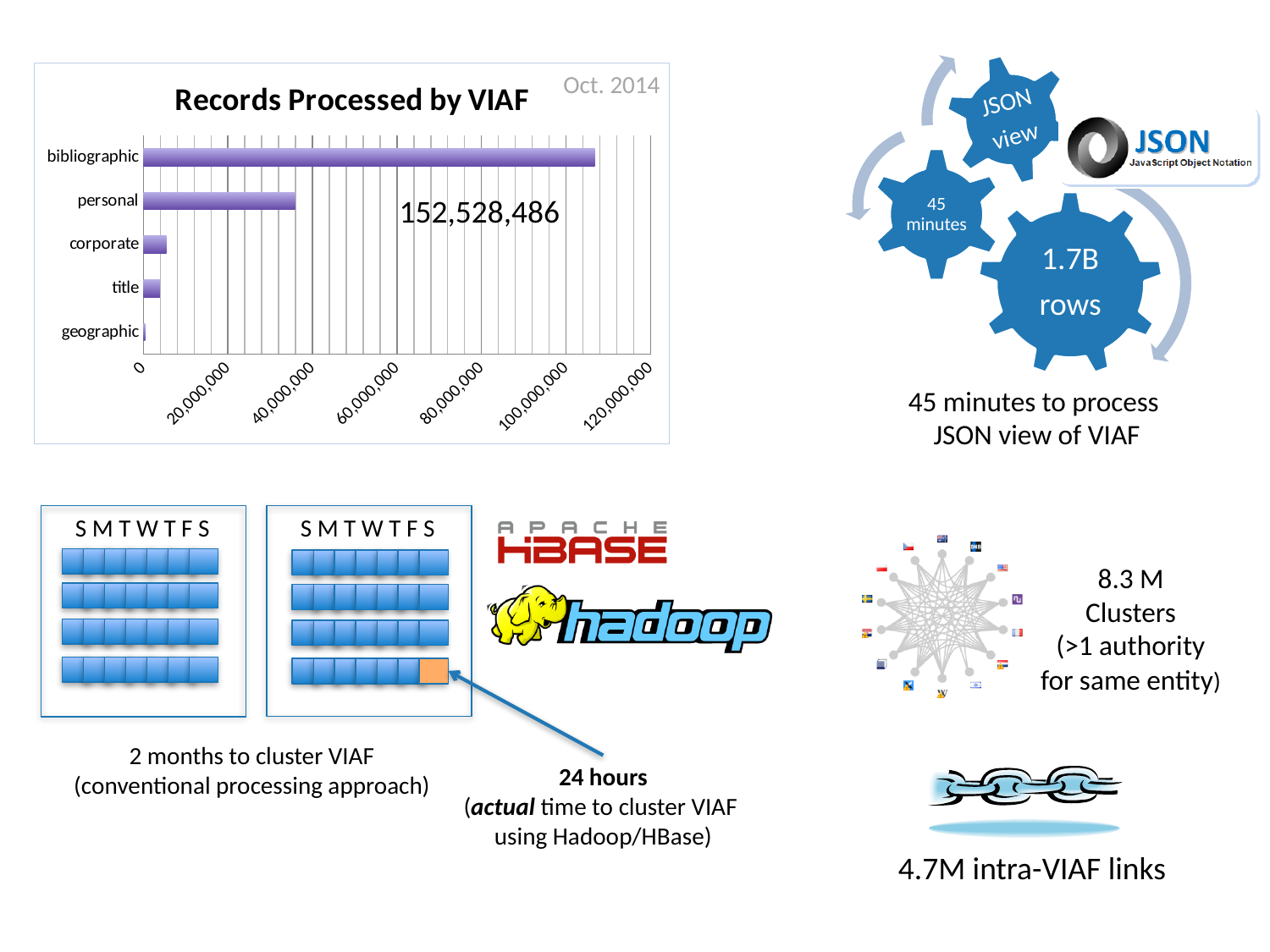
What type of chart is 'Records Processed by VIAF'? bar chart Which category has the lowest value in the 'Records Processed by VIAF' chart? geographic In the 'Records Processed by VIAF' chart, is the value for personal greater or less than 40,000,000? less In the 'Records Processed by VIAF' chart, which is larger, personal or corporate? personal In the 'Records Processed by VIAF' chart, is the value for personal greater or less than 20,000,000? greater In the 'Records Processed by VIAF' chart, which is larger, bibliographic or personal? bibliographic What date label appears in the top right corner of the 'Records Processed by VIAF' chart? Oct. 2014 What is the title of the bar chart on the slide? Records Processed by VIAF How many categories are shown in the 'Records Processed by VIAF' chart? 5 Which category has the highest value in the 'Records Processed by VIAF' chart? bibliographic In the 'Records Processed by VIAF' chart, is the value for bibliographic greater or less than 100,000,000? greater